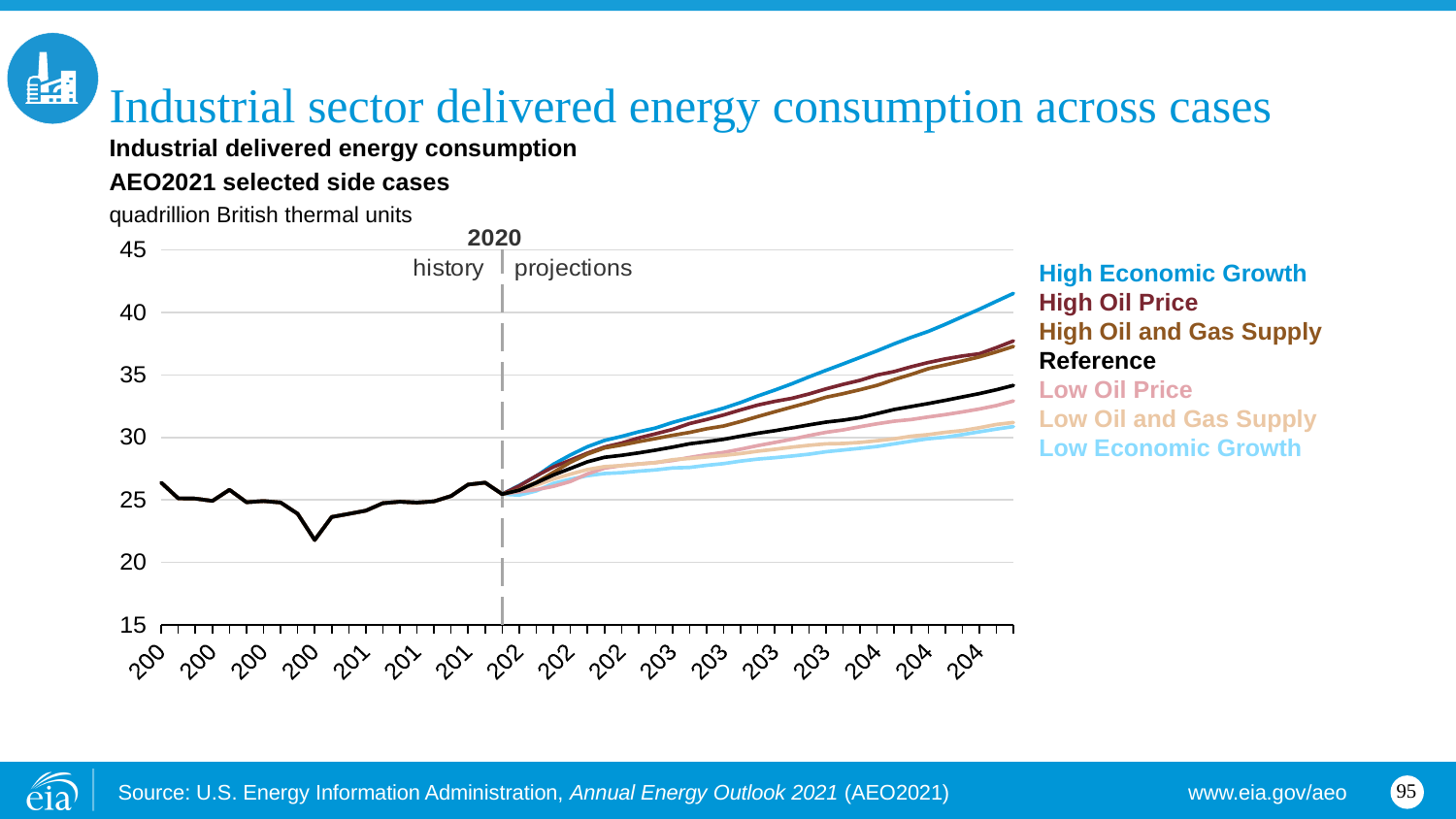
Which year marks the boundary between history and projections on the chart? 2020 What unit is the industrial delivered energy consumption measured in? quadrillion British thermal units Do the projected values for the cases generally rise or fall after 2020? rise Which case has the highest industrial delivered energy consumption at the end of the projection period? High Economic Growth At the end of the projection period, is the value for the High Economic Growth case greater or less than 40? greater At the end of the projection period, is the value for the Reference case greater or less than 30? greater At the end of the projection period, is the value for the Low Economic Growth case greater or less than 35? less How many series (cases) does the legend list? 7 What kind of chart is shown on the slide? line chart At the end of the projection period, which is larger: the High Oil Price case or the Low Oil Price case? High Oil Price Which case has the lowest industrial delivered energy consumption at the end of the projection period? Low Economic Growth